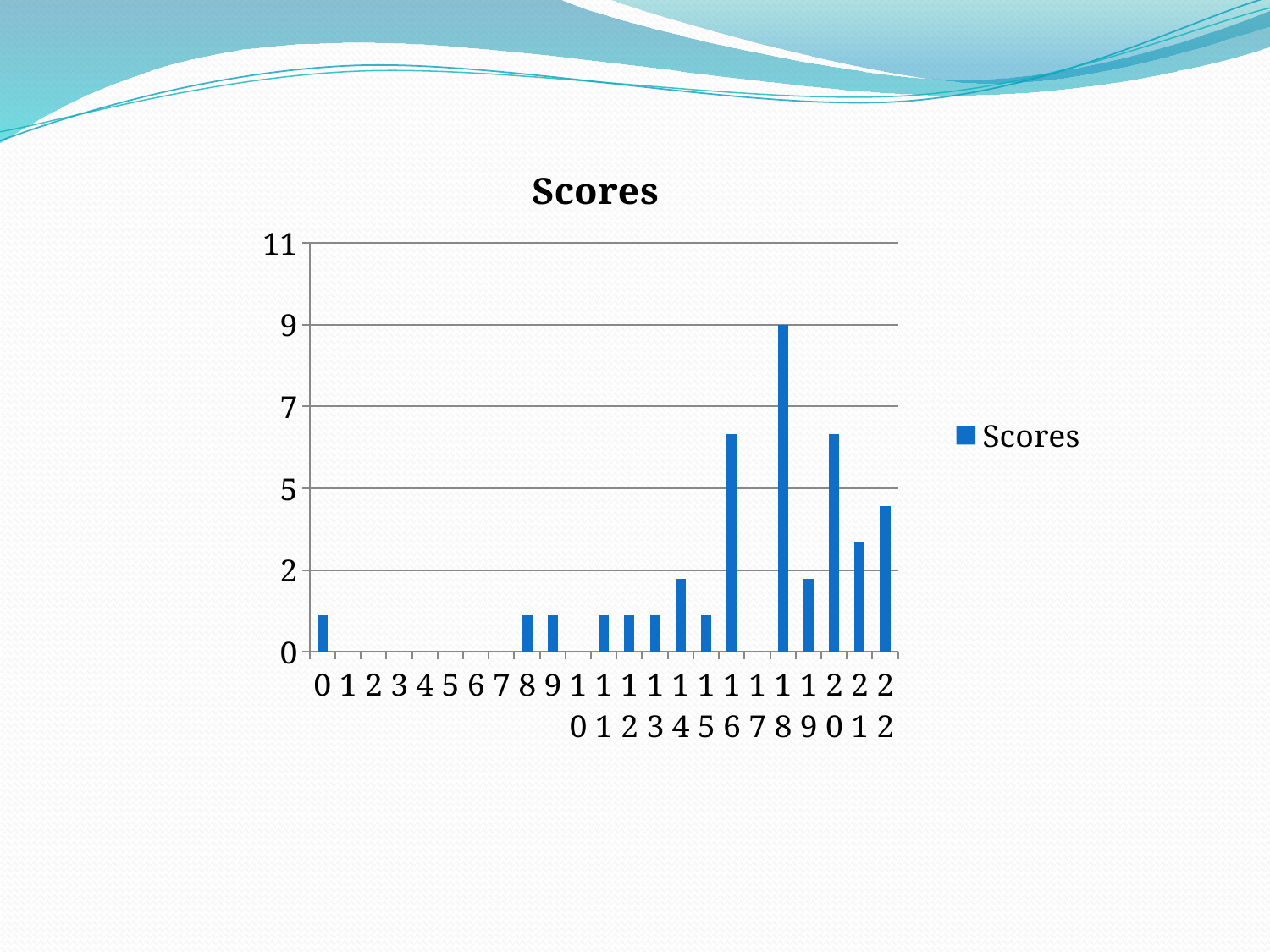
What kind of chart is shown on the slide? bar chart Which category has the highest score? 18 Which is larger, the value for category 16 or the value for category 22? 16 Which is larger, the value for category 18 or the value for category 20? 18 What is the title of the chart? Scores How many categories are shown on the x axis? 23 Is the value for category 22 greater or less than 5? less Is the value for category 16 greater or less than 5? greater How many series does the legend list? 1 What is the value for category 18? 9 Is the value for category 18 greater or less than 7? greater Which is larger, the value for category 21 or the value for category 22? 22